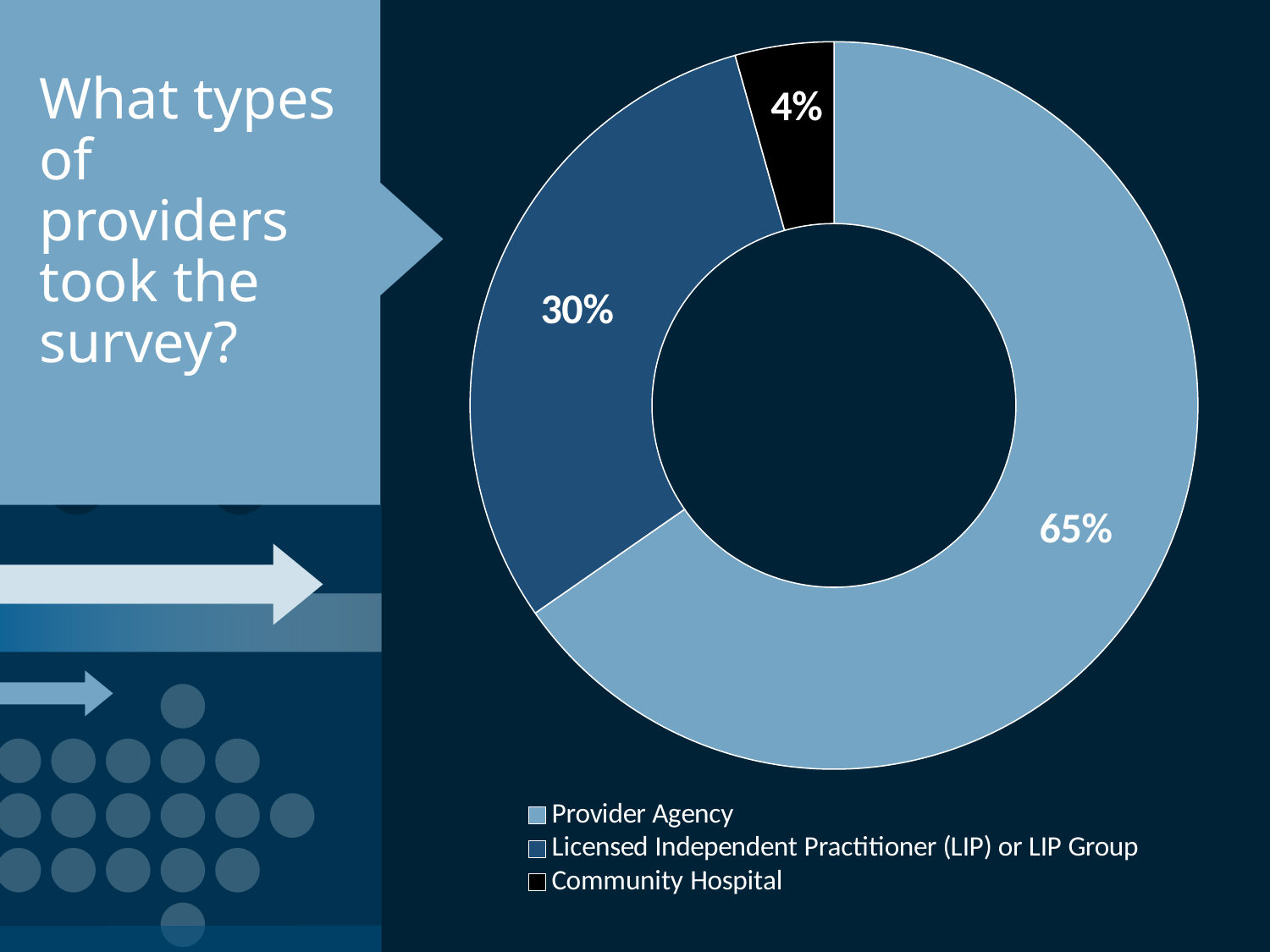
What share of survey respondents were Licensed Independent Practitioners (LIP) or LIP Groups? 30% What is the difference in percentage points between the LIP or LIP Group share and the Community Hospital share? 26 What kind of chart is shown on the slide? Doughnut (pie) chart What question does the slide title ask? What types of providers took the survey? Which colour represents Community Hospital in the chart? Black Which provider type has the smallest share of the chart? Community Hospital Which is larger: the share for Provider Agency or the share for Community Hospital? Provider Agency Which provider type has the largest share of the chart? Provider Agency What is the difference in percentage points between the Provider Agency share and the LIP or LIP Group share? 35 What share of survey respondents were Provider Agencies? 65% What share of survey respondents were Community Hospitals? 4% How many provider types are shown in the chart? 3